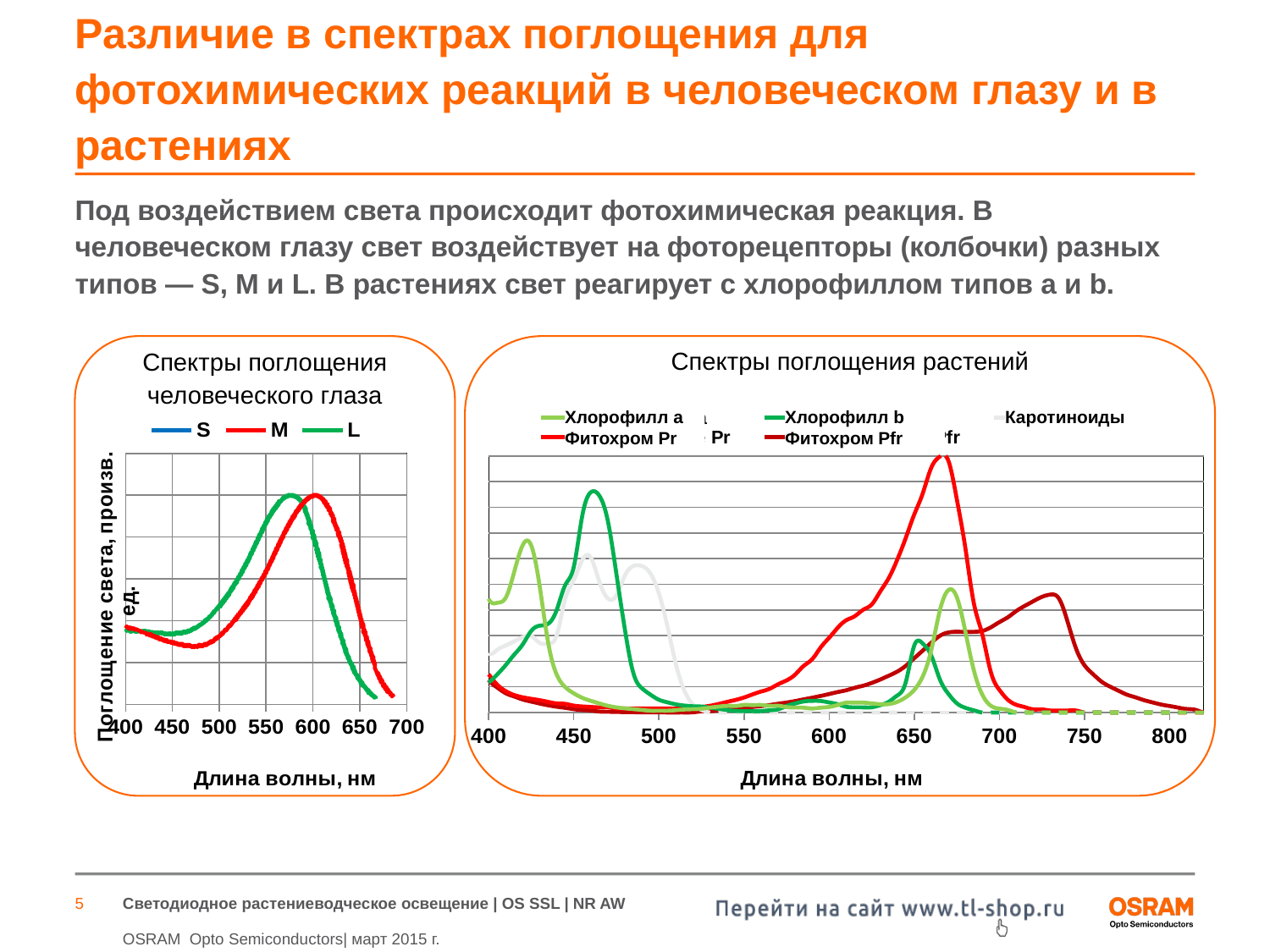
What kind of chart is the left chart, 'Спектры поглощения человеческого глаза'? line chart What is the title of the right chart? Спектры поглощения растений What kind of chart is the right chart, 'Спектры поглощения растений'? line chart In the left chart ('Спектры поглощения человеческого глаза'), which series reaches its peak at a longer wavelength, M or L? M How many series does the legend of the left chart ('Спектры поглощения человеческого глаза') list? 3 In the right chart ('Спектры поглощения растений'), which series has its peak at the longest wavelength? Фитохром Pfr In the right chart ('Спектры поглощения растений'), which series has the higher peak in the 400–500 nm region, Хлорофилл a or Хлорофилл b? Хлорофилл b In the left chart ('Спектры поглощения человеческого глаза'), does the M series rise or fall between 600 nm and 700 nm? fall What is the x-axis title of the left chart ('Спектры поглощения человеческого глаза')? Длина волны, нм How many series does the legend of the right chart ('Спектры поглощения растений') list? 5 In the right chart ('Спектры поглощения растений'), which series has the highest peak? Фитохром Pr